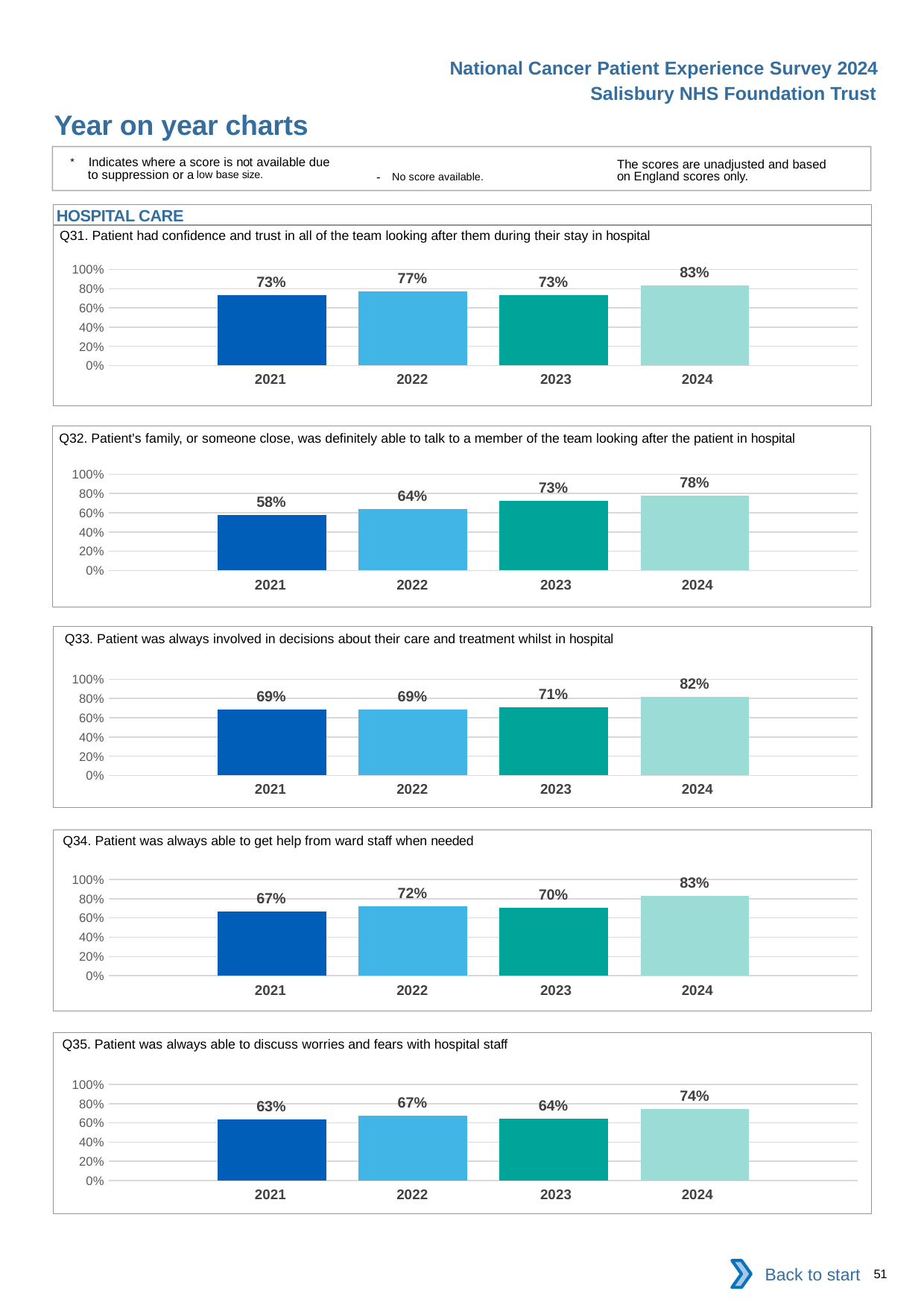
In the Q32 chart (patient's family was definitely able to talk to a member of the team), what is the difference between the 2024 and 2021 values? 20% What kind of chart is the Q32 chart (patient's family was definitely able to talk to a member of the team)? bar chart In the Q33 chart (patient was always involved in decisions about their care), what is the value for 2022? 69% In the Q34 chart (patient was always able to get help from ward staff), which is larger, the value for 2022 or the value for 2023? 2022 In the Q35 chart (patient was always able to discuss worries and fears), is the value for 2024 greater or less than 80%? less In the Q31 chart (patient had confidence and trust in all of the team), what is the value for 2024? 83% In the Q35 chart (patient was always able to discuss worries and fears), what is the value for 2021? 63% In the Q33 chart (patient was always involved in decisions about their care), which year has the highest value? 2024 How many years are shown on the x axis of the Q31 chart (patient had confidence and trust in all of the team)? 4 In the Q32 chart (patient's family was definitely able to talk to a member of the team), do the values rise or fall from 2021 to 2024? rise In the Q34 chart (patient was always able to get help from ward staff), what is the difference between the 2024 and 2023 values? 13% In the Q32 chart (patient's family was definitely able to talk to a member of the team), which year has the lowest value? 2021